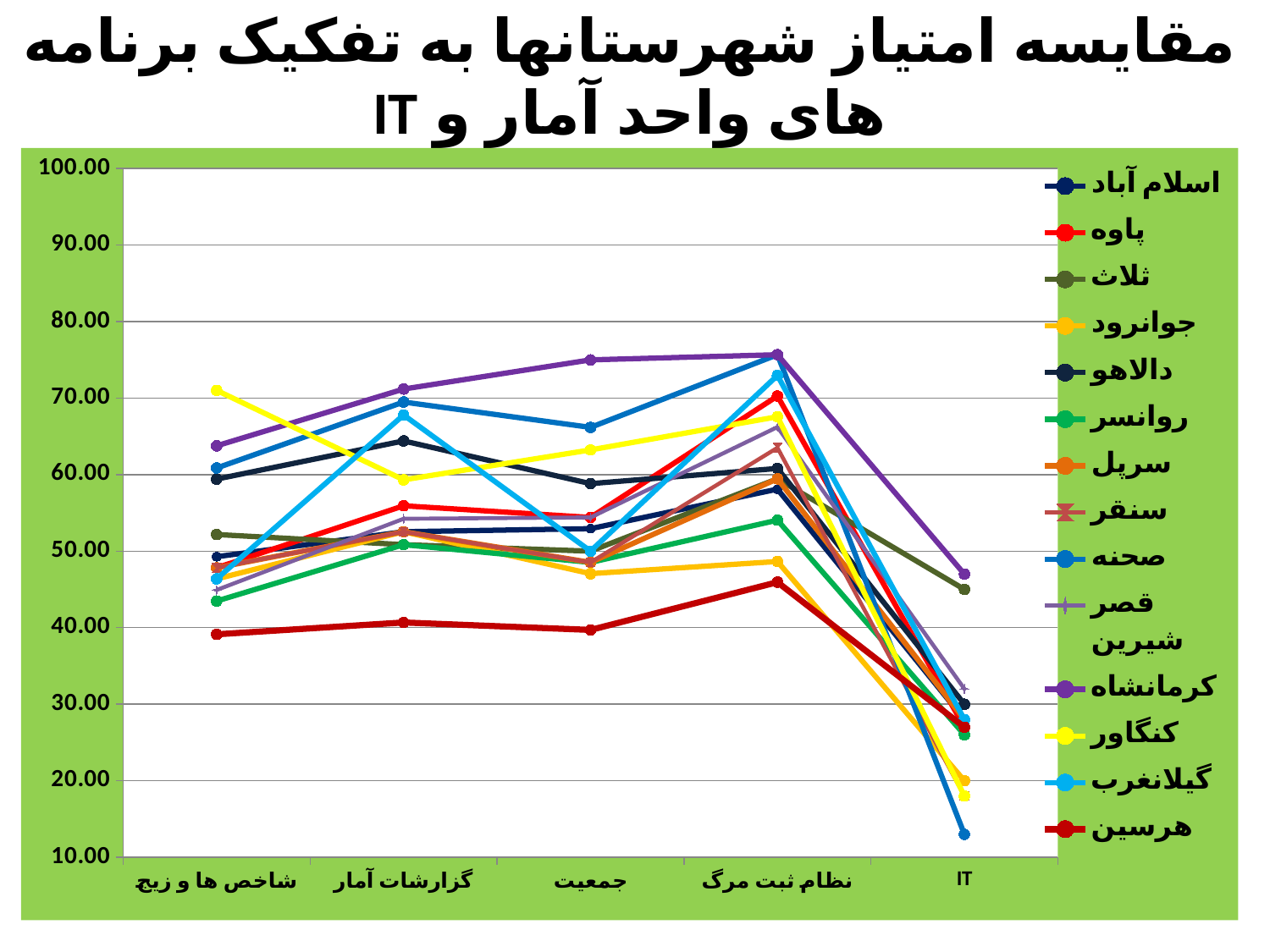
Which series has the lowest value for IT? صحنه Which series has the highest value for IT? کرمانشاه Which is larger at IT: the value for ثلاث or the value for صحنه? ثلاث Does the value for کرمانشاه rise or fall from نظام ثبت مرگ to IT? fall How many series does the legend list? 14 Which series has the highest value for جمعیت? کرمانشاه What kind of chart is shown on the slide? line chart Is the value for کرمانشاه at جمعیت greater or less than 70? greater Is the value for صحنه at IT greater or less than 20? less Is the value for هرسین at نظام ثبت مرگ greater or less than 50? less Which series has the lowest value for جمعیت? هرسین How many categories are shown along the x axis? 5